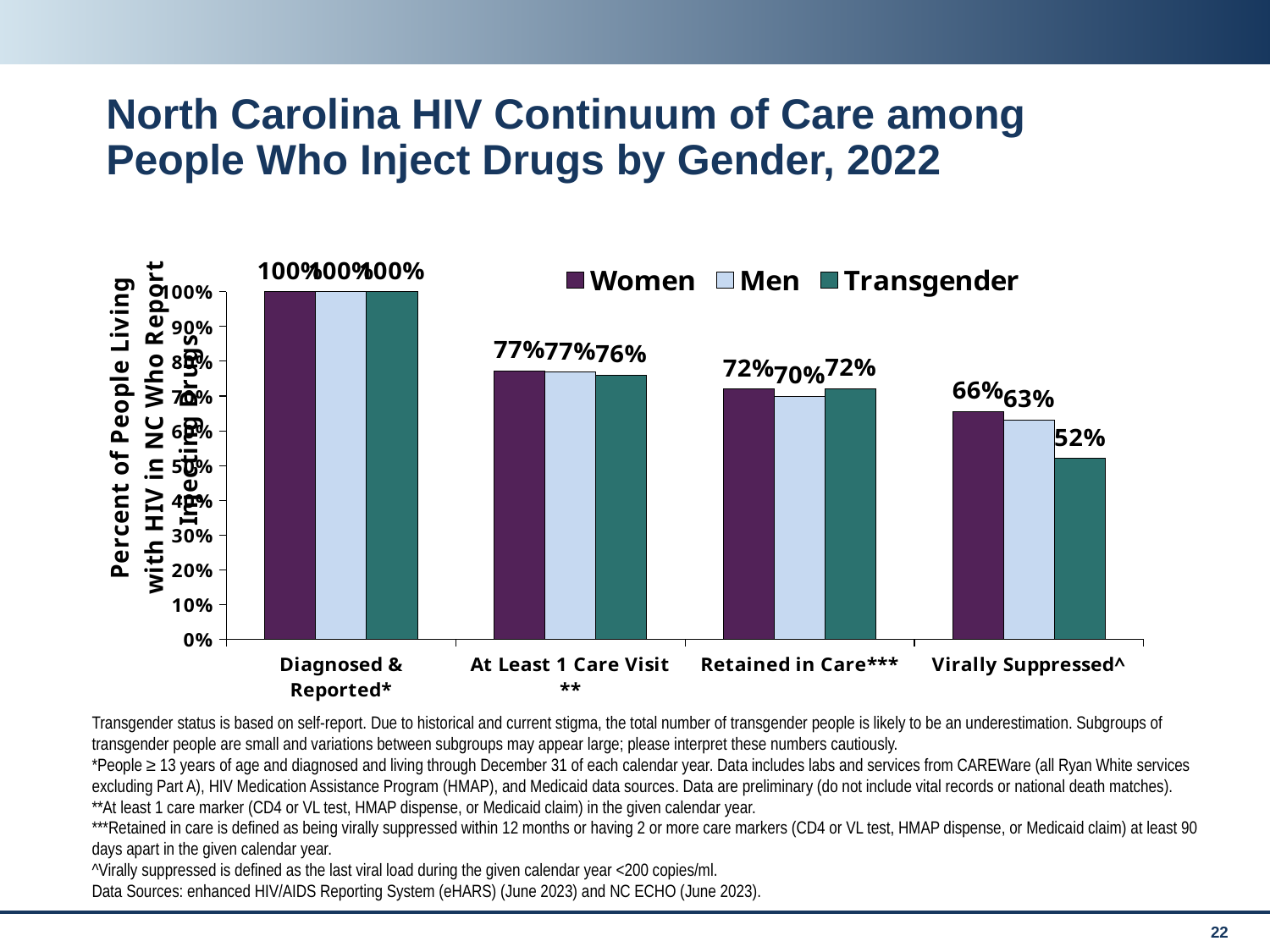
What is the value for Women in the Virally Suppressed^ category? 66% Do the Women values rise or fall across the categories from left to right? Fall What kind of chart is shown on the slide? Bar chart Which gender group has the lowest value in the Virally Suppressed^ category? Transgender What is the difference between the Women and Transgender values in the Virally Suppressed^ category? 14% Which series is shown in the darkest purple colour? Women What is the value for Transgender in the At Least 1 Care Visit** category? 76% How many series does the legend list? 3 How many categories are shown on the x axis? 4 What is the value for Men in the Retained in Care*** category? 70% Which is larger: the Men value for Retained in Care*** or the Transgender value for Retained in Care***? Transgender What is the value for Transgender in the Virally Suppressed^ category? 52%